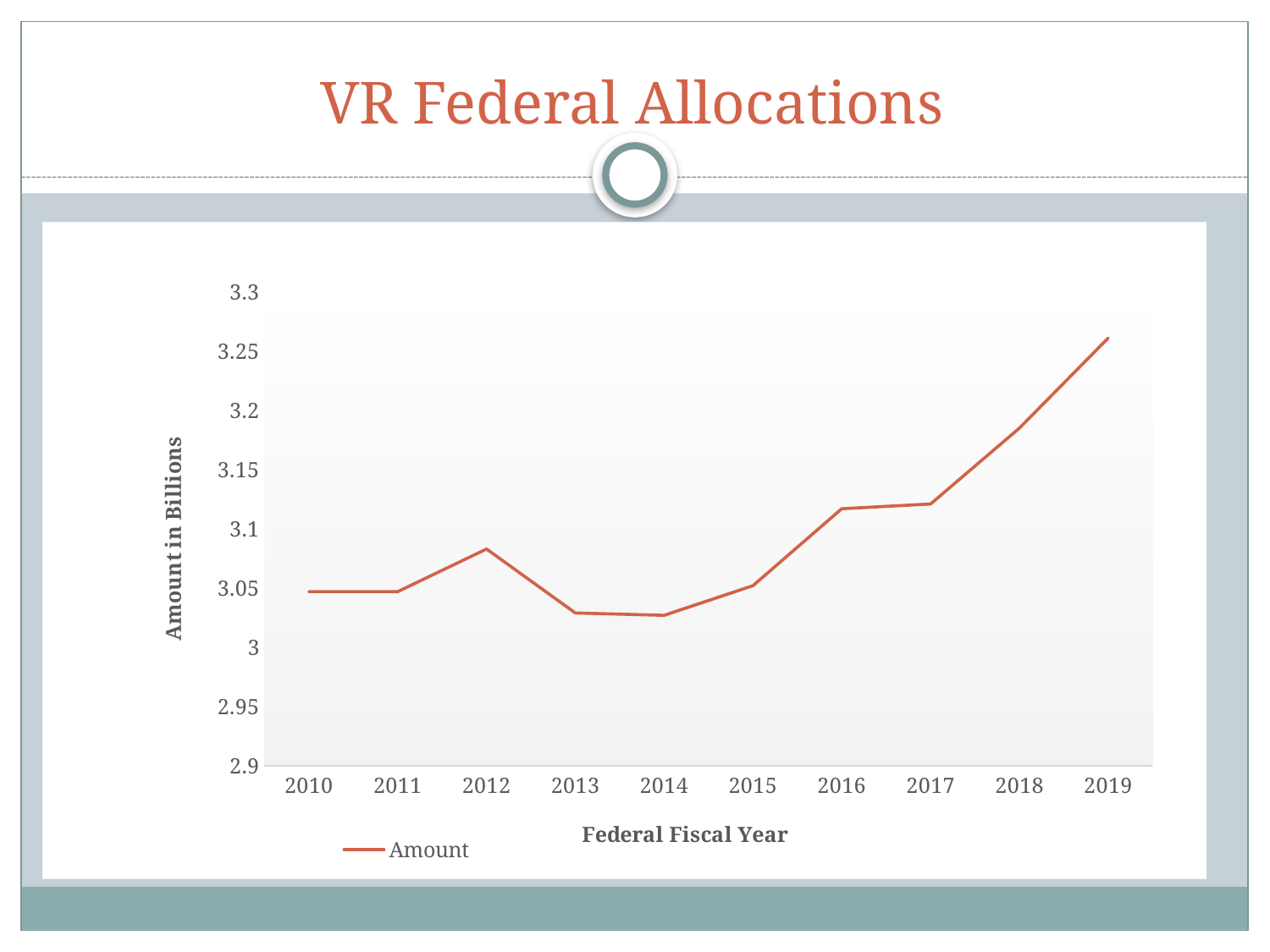
Is the value for 2018 greater or less than 3.15? greater Is the value for 2013 greater or less than 3.05? less How many series does the legend list? 1 How many federal fiscal years are plotted on the x axis? 10 Is the value for 2019 greater or less than 3.2? greater Does the allocation amount rise or fall between 2015 and 2019? rise What kind of chart is shown on the slide? line chart Which year has the larger allocation amount, 2012 or 2013? 2012 Which federal fiscal year has the highest allocation amount? 2019 What is the title of the y axis? Amount in Billions What is the title of the x axis? Federal Fiscal Year